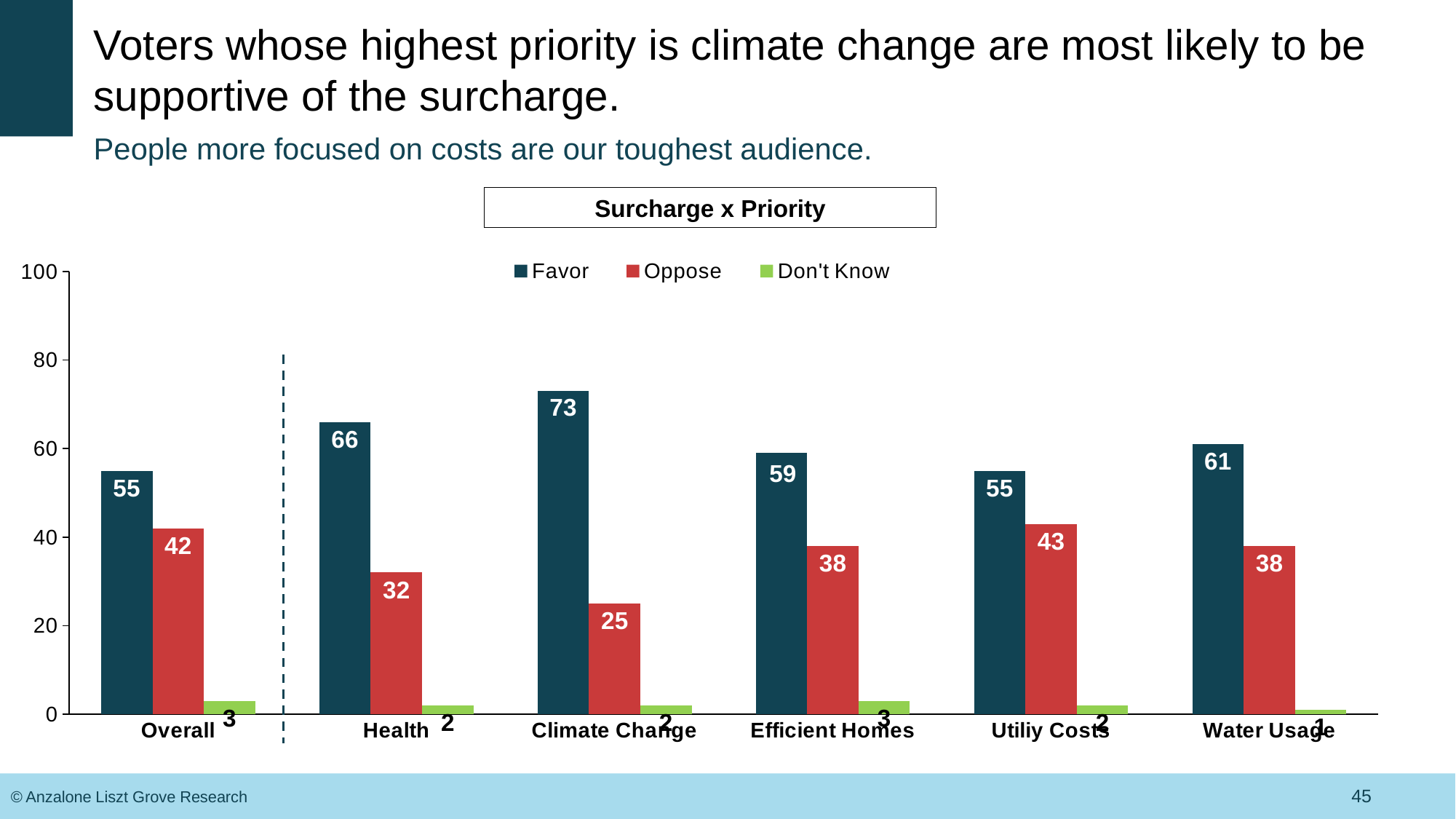
What is the Oppose value for Utiliy Costs? 43 What is the Don't Know value for Water Usage? 1 What is the Favor value for Climate Change? 73 Which is larger, the Favor value for Efficient Homes or the Favor value for Water Usage? Water Usage What is the title of the chart? Surcharge x Priority Which category has the highest Favor value? Climate Change How many categories are shown on the x axis? 6 What is the difference between the Favor and Oppose values for Health? 34 Which category has the lowest Oppose value? Climate Change How many series does the legend list? 3 What kind of chart is shown on the slide? Bar chart Is the Oppose value for Overall greater or less than 40? greater